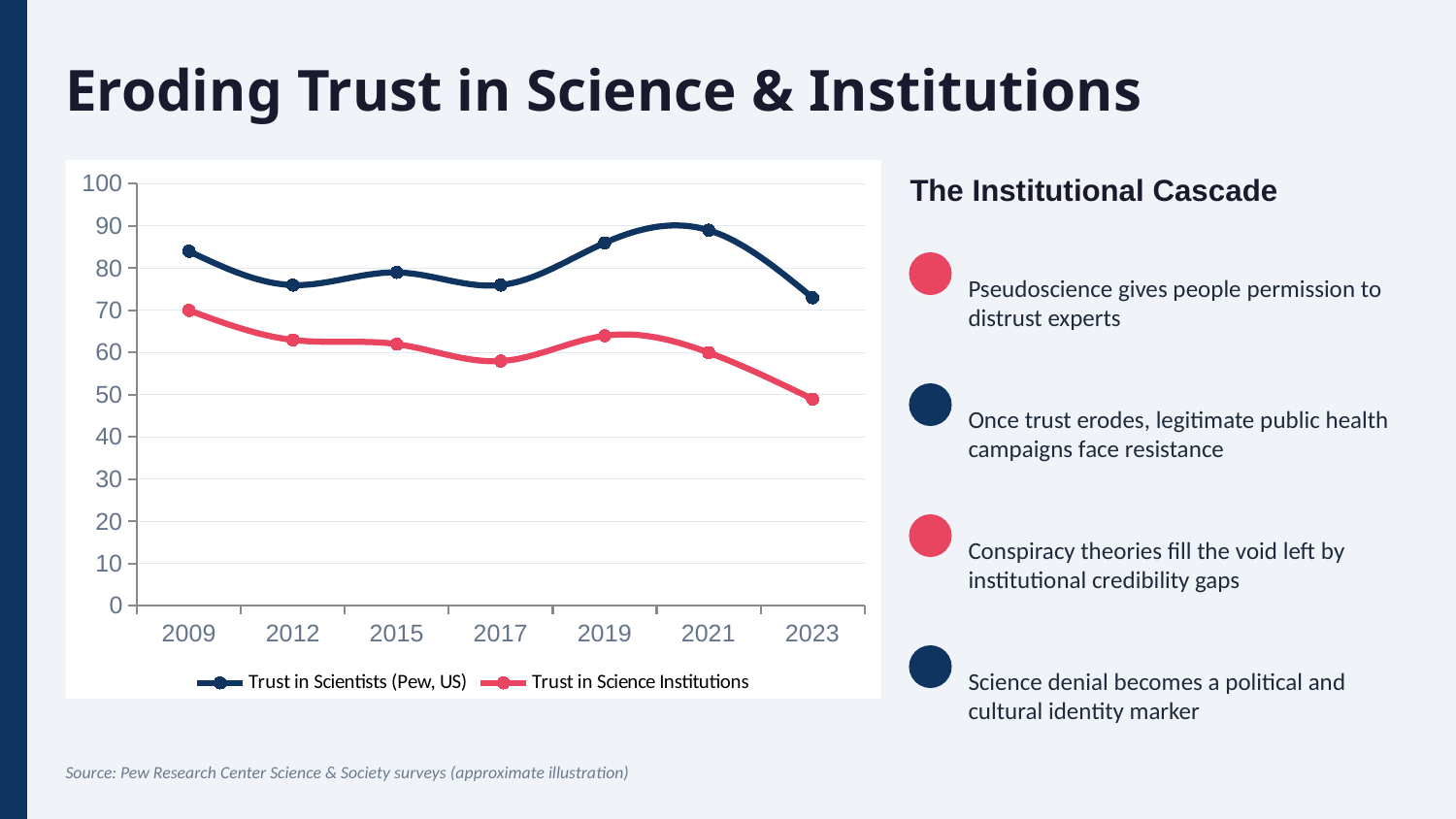
In which year is Trust in Science Institutions at its highest? 2009 Is the value for Trust in Scientists (Pew, US) in 2023 greater or less than 80? less How many series does the chart's legend list? 2 What kind of chart is shown on the slide? Line chart In 2023, which series has the larger value: Trust in Scientists (Pew, US) or Trust in Science Institutions? Trust in Scientists (Pew, US) Is the value for Trust in Science Institutions in 2009 greater or less than 60? greater Is the value for Trust in Scientists (Pew, US) in 2009 greater or less than 80? greater Overall, does Trust in Science Institutions rise or fall from 2009 to 2023? Fall How many years are plotted along the x axis of the chart? 7 Which colour is used for the Trust in Science Institutions line? Red In which year is Trust in Science Institutions at its lowest? 2023